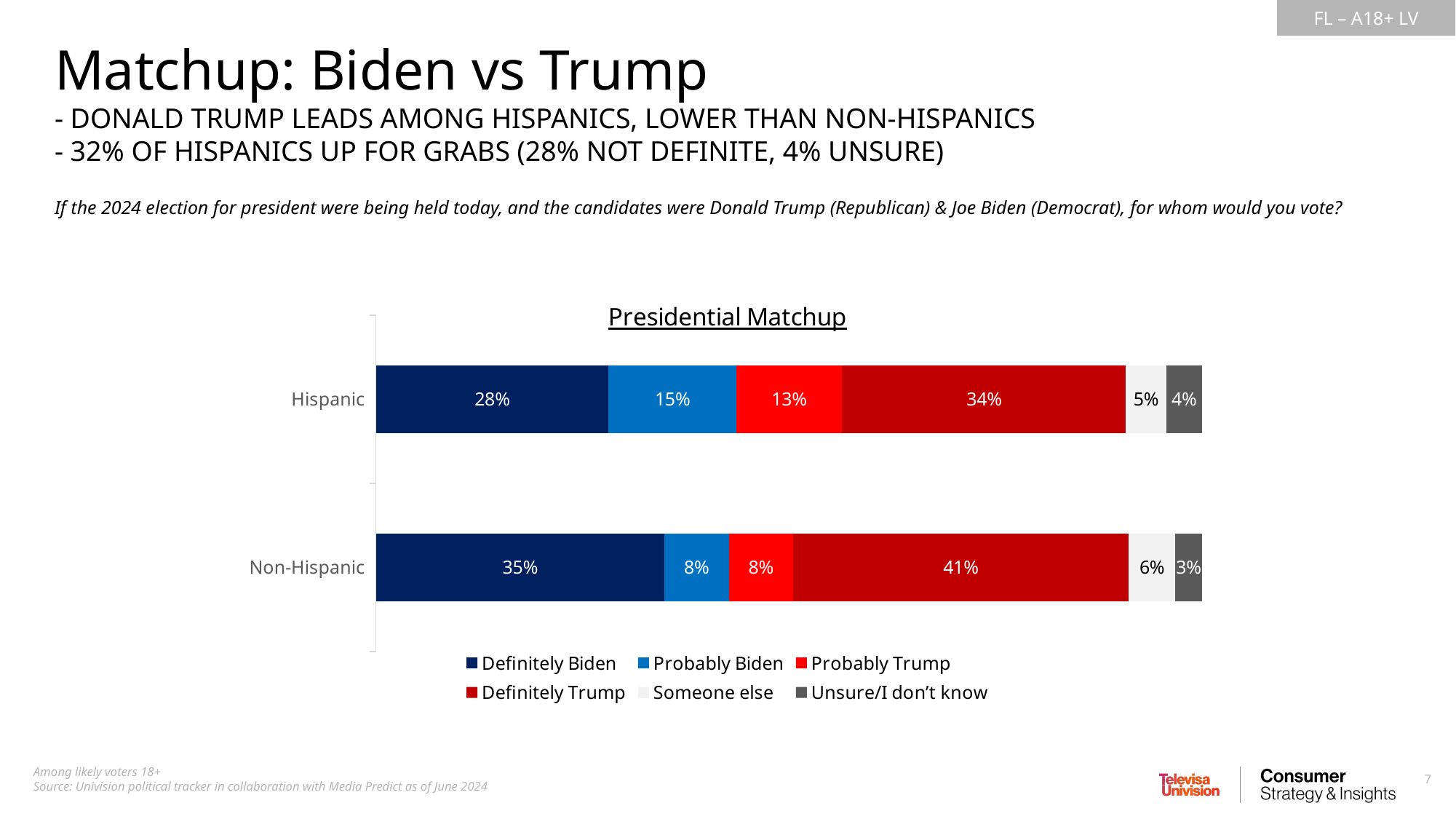
How many series does the legend list? 6 How many categories (bars) are shown in the chart? 2 Which is larger: Probably Biden for Hispanic or Probably Biden for Non-Hispanic respondents? Hispanic What is the value for Definitely Biden among Non-Hispanic respondents? 35% What is the value for Definitely Trump among Hispanic respondents? 34% What is the value for Unsure/I don't know among Non-Hispanic respondents? 3% What is the difference between Definitely Trump for Non-Hispanic and Definitely Trump for Hispanic respondents? 7% Which response category has the highest value in the Hispanic bar? Definitely Trump What kind of chart is shown on the slide? Stacked bar chart What is the title of the chart? Presidential Matchup Which response category has the lowest value in the Non-Hispanic bar? Unsure/I don't know What is the value for Probably Biden among Hispanic respondents? 15%